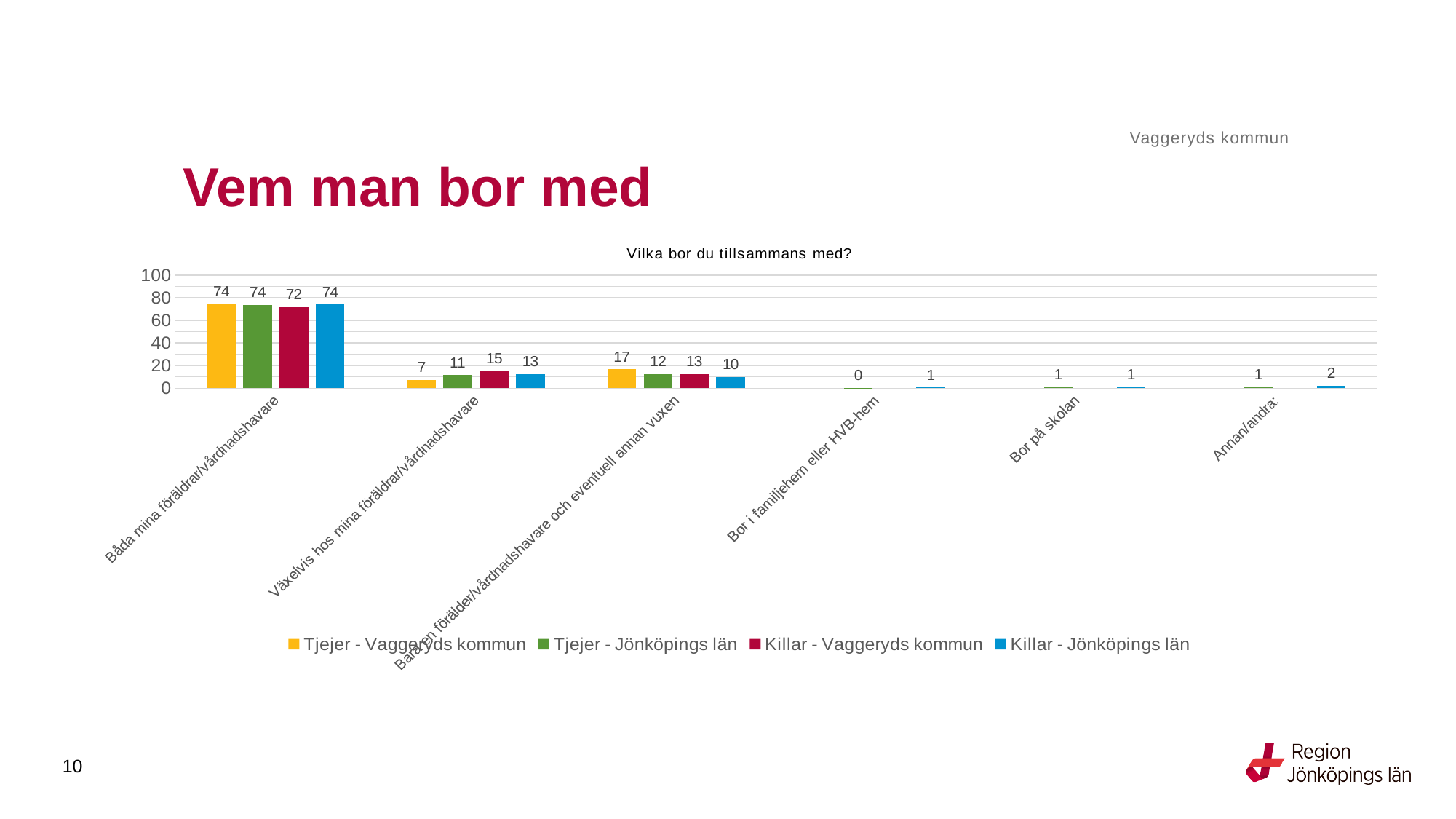
In the category "Bara en förälder/vårdnadshavare och eventuell annan vuxen", which is larger: Tjejer - Vaggeryds kommun or Tjejer - Jönköpings län? Tjejer - Vaggeryds kommun What is the value for Killar - Jönköpings län in the category "Bara en förälder/vårdnadshavare och eventuell annan vuxen"? 10 Which series has the highest value in the category "Växelvis hos mina föräldrar/vårdnadshavare"? Killar - Vaggeryds kommun What is the difference between Killar - Vaggeryds kommun and Tjejer - Vaggeryds kommun in the category "Växelvis hos mina föräldrar/vårdnadshavare"? 8 What is the value for Tjejer - Vaggeryds kommun in the category "Bara en förälder/vårdnadshavare och eventuell annan vuxen"? 17 Which series has the lowest value in the category "Bara en förälder/vårdnadshavare och eventuell annan vuxen"? Killar - Jönköpings län How many series does the legend list? 4 What is the title of the chart? Vilka bor du tillsammans med? What is the value for Killar - Vaggeryds kommun in the category "Båda mina föräldrar/vårdnadshavare"? 72 What kind of chart is shown on the slide? Bar chart What is the value for Tjejer - Vaggeryds kommun in the category "Växelvis hos mina föräldrar/vårdnadshavare"? 7 How many categories are shown on the x axis of the chart? 6